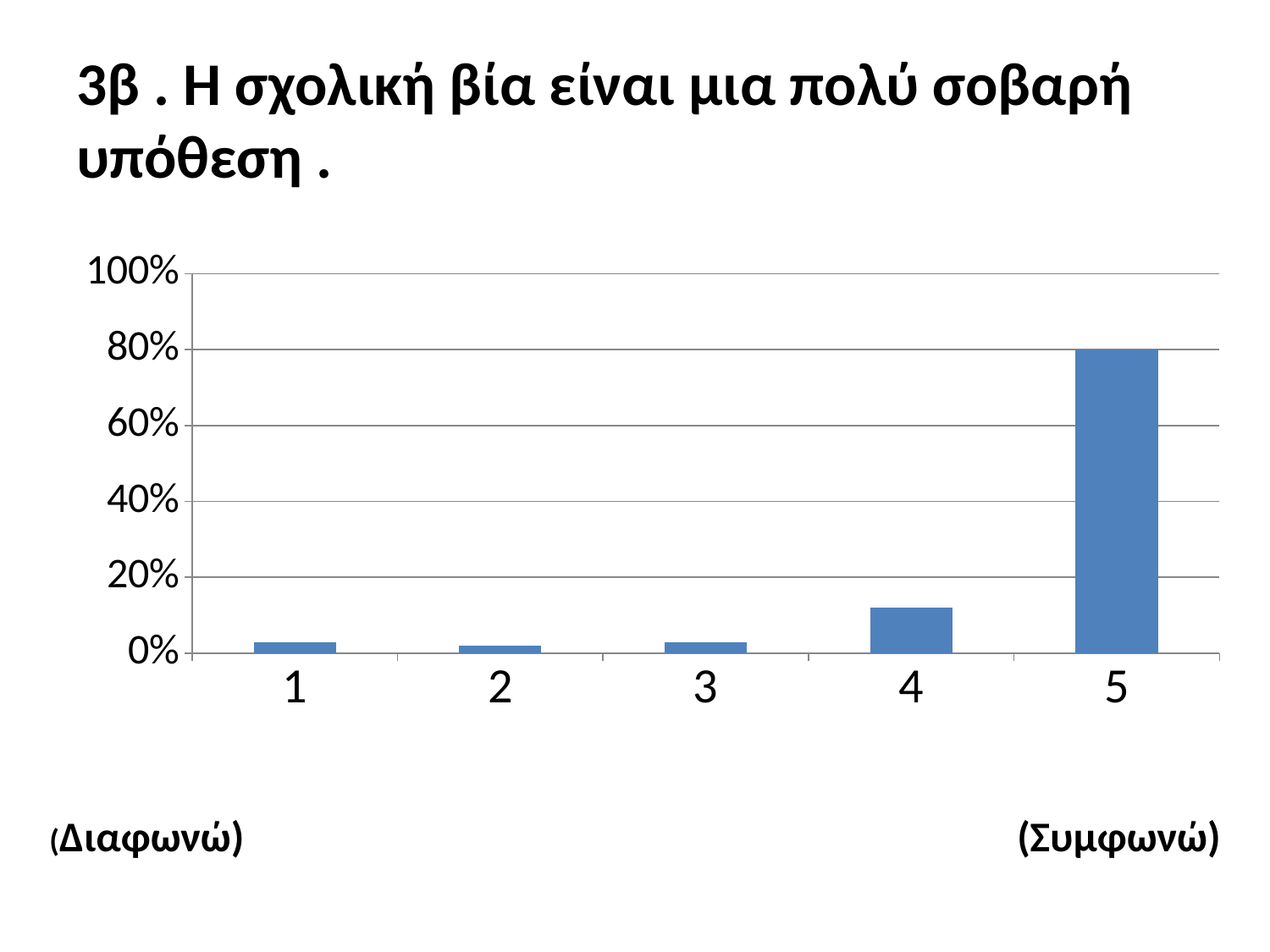
What is the title of the slide containing the chart? 3β . Η σχολική βία είναι μια πολύ σοβαρή υπόθεση . Is the value for category 4 greater or less than 20%? less Which is larger, the value for category 1 or the value for category 4? 4 What label appears below the right end of the x axis, under category 5? (Συμφωνώ) Which category has the highest value in the chart? 5 What is the value for category 5? 80% Is the value for category 1 greater or less than 20%? less Which is larger, the value for category 4 or the value for category 5? 5 Do the values generally rise or fall from category 1 to category 5? rise How many categories are shown on the x axis of the chart? 5 What kind of chart is shown on the slide? Bar chart Is the value for category 5 greater or less than 60%? greater